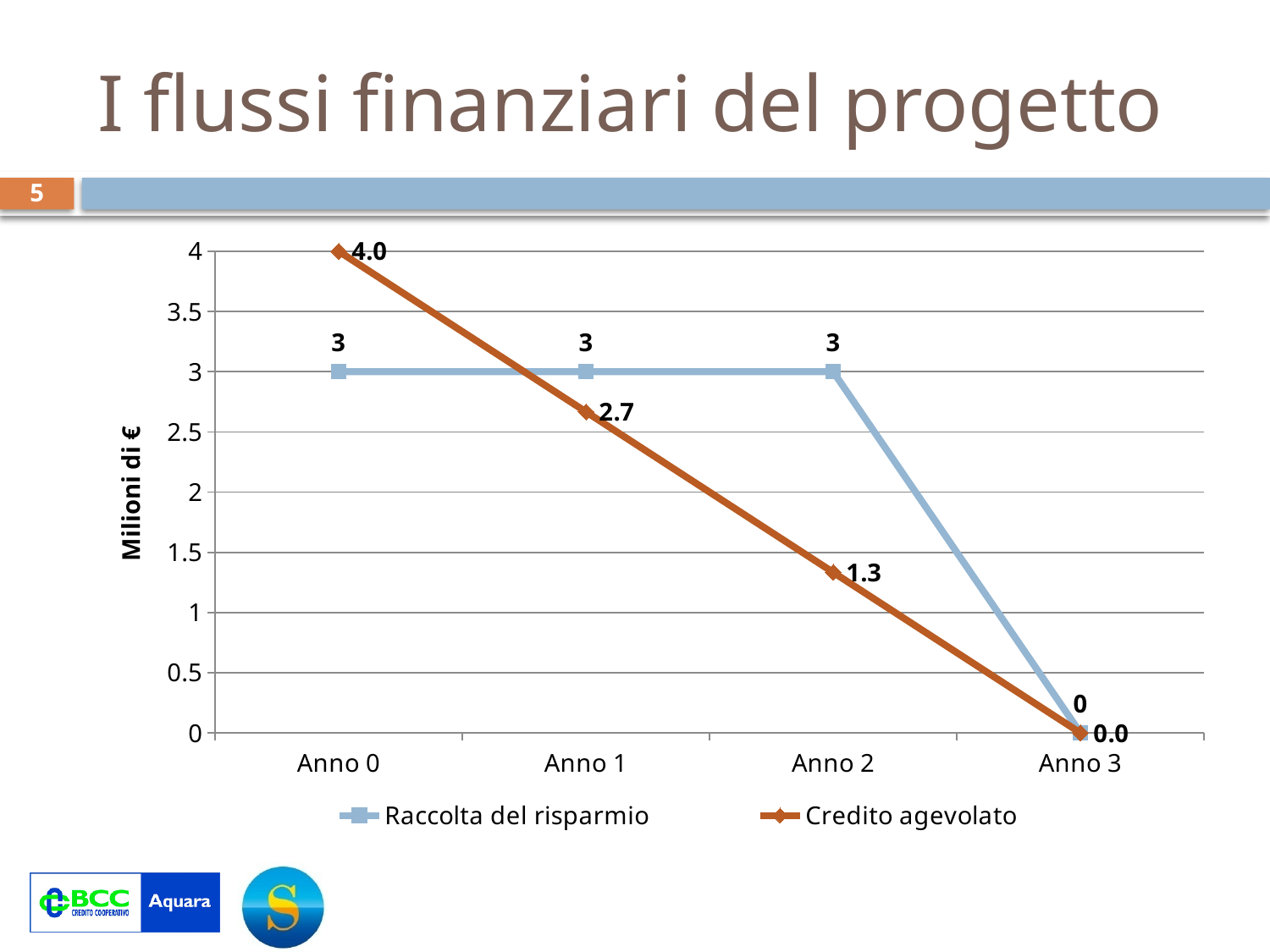
How many series does the legend list? 2 What is the value of Credito agevolato at Anno 1? 2.7 Does Credito agevolato rise or fall from Anno 0 to Anno 3? fall Which series has the larger value at Anno 1, Raccolta del risparmio or Credito agevolato? Raccolta del risparmio What is the value of Raccolta del risparmio at Anno 2? 3 What is the value of Credito agevolato at Anno 2? 1.3 How many categories are shown on the x axis? 4 What type of chart is shown on the slide? line chart What is the value of Credito agevolato at Anno 0? 4.0 At which year is Credito agevolato highest? Anno 0 What is the value of Raccolta del risparmio at Anno 3? 0 What is the difference between Credito agevolato at Anno 0 and at Anno 1? 1.3